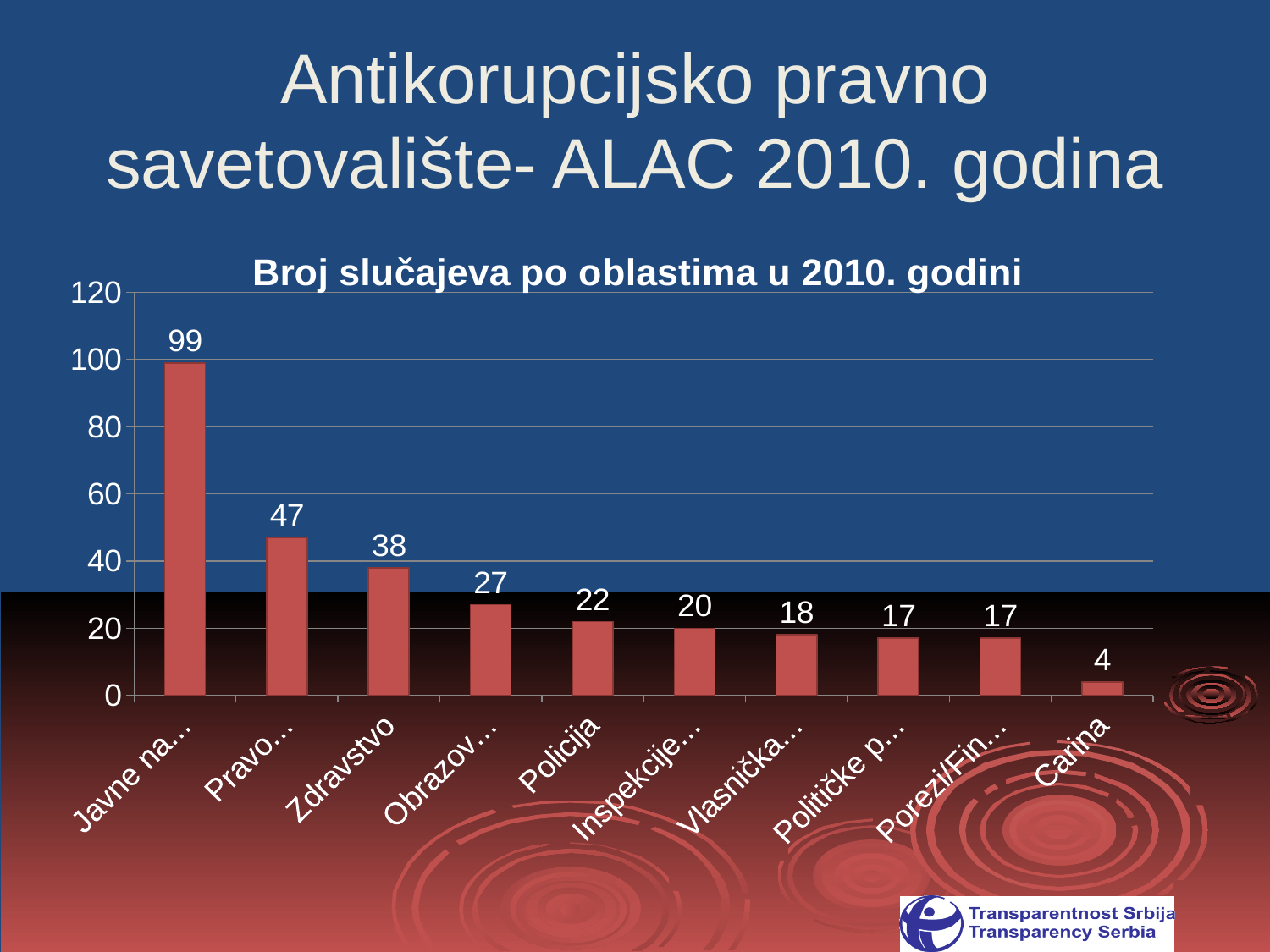
Is the value for Zdravstvo greater or less than 40? less What is the value for Carina? 4 What is the highest value shown on the chart? 99 How many bars are shown on the chart? 10 What is the value for Zdravstvo? 38 What is the difference between the values for Policija and Carina? 18 What is the value for Policija? 22 What is the difference between the values for Zdravstvo and Policija? 16 What kind of chart is shown on the slide? bar chart Which category has the lowest value? Carina Which is larger, the value for Zdravstvo or the value for Policija? Zdravstvo What is the title of the chart? Broj slučajeva po oblastima u 2010. godini